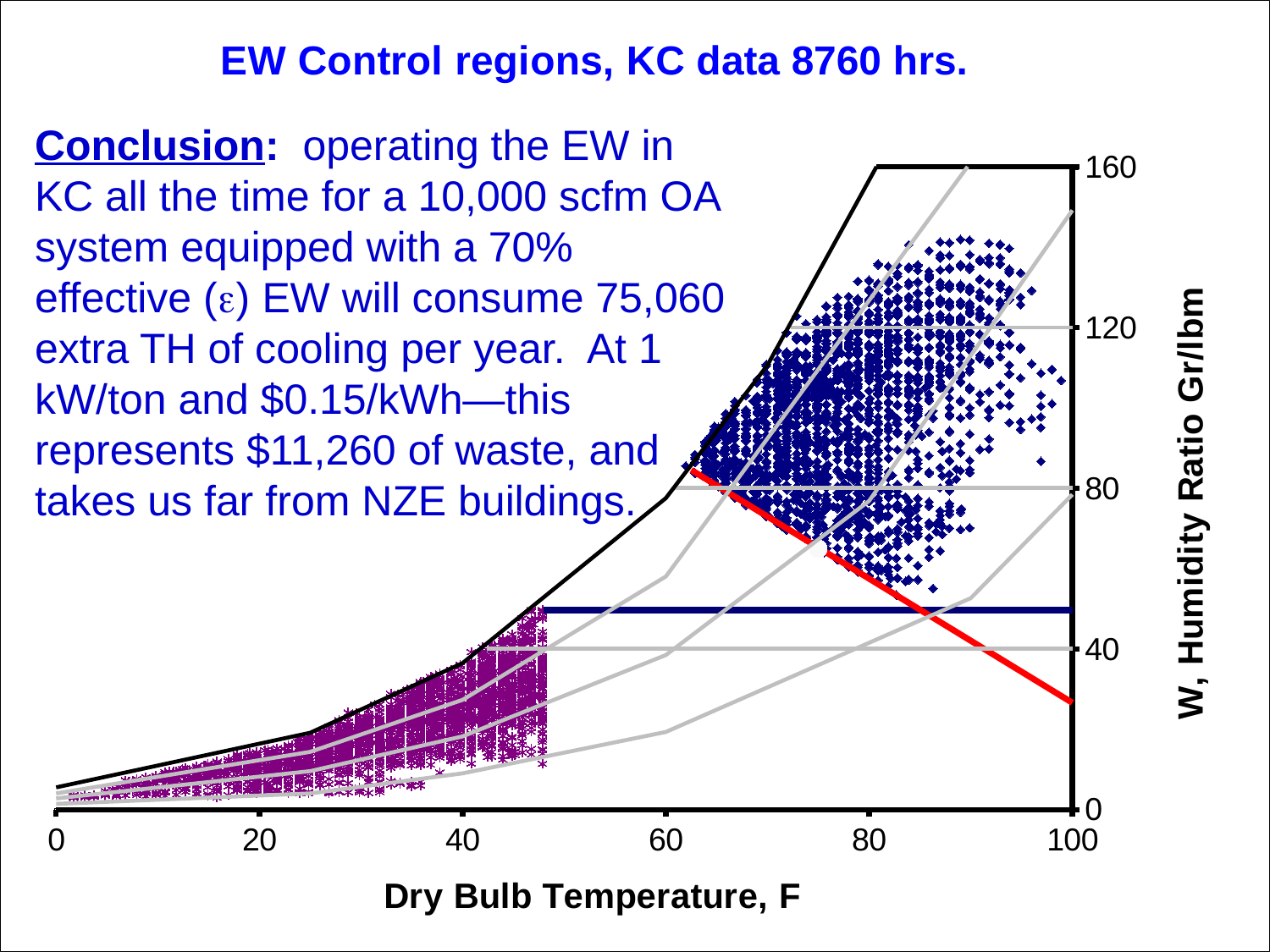
What is the highest value shown on the y axis of the chart? 160 What kind of chart is shown on the slide? scatter chart What is the title of the chart? EW Control regions, KC data 8760 hrs. Does the red line on the chart rise or fall as dry bulb temperature increases from 60 to 100 F? fall Is the horizontal dark blue line on the chart at a humidity ratio greater or less than 40? greater What is the label of the x axis of the chart? Dry Bulb Temperature, F Does the black upper boundary line on the chart rise or fall as dry bulb temperature increases from 0 to 80 F? rise Do the purple data points on the chart lie at dry bulb temperatures greater or less than 60 F? less At a dry bulb temperature of 100 F, is the red line at a humidity ratio greater or less than 40? less What is the highest value shown on the x axis of the chart? 100